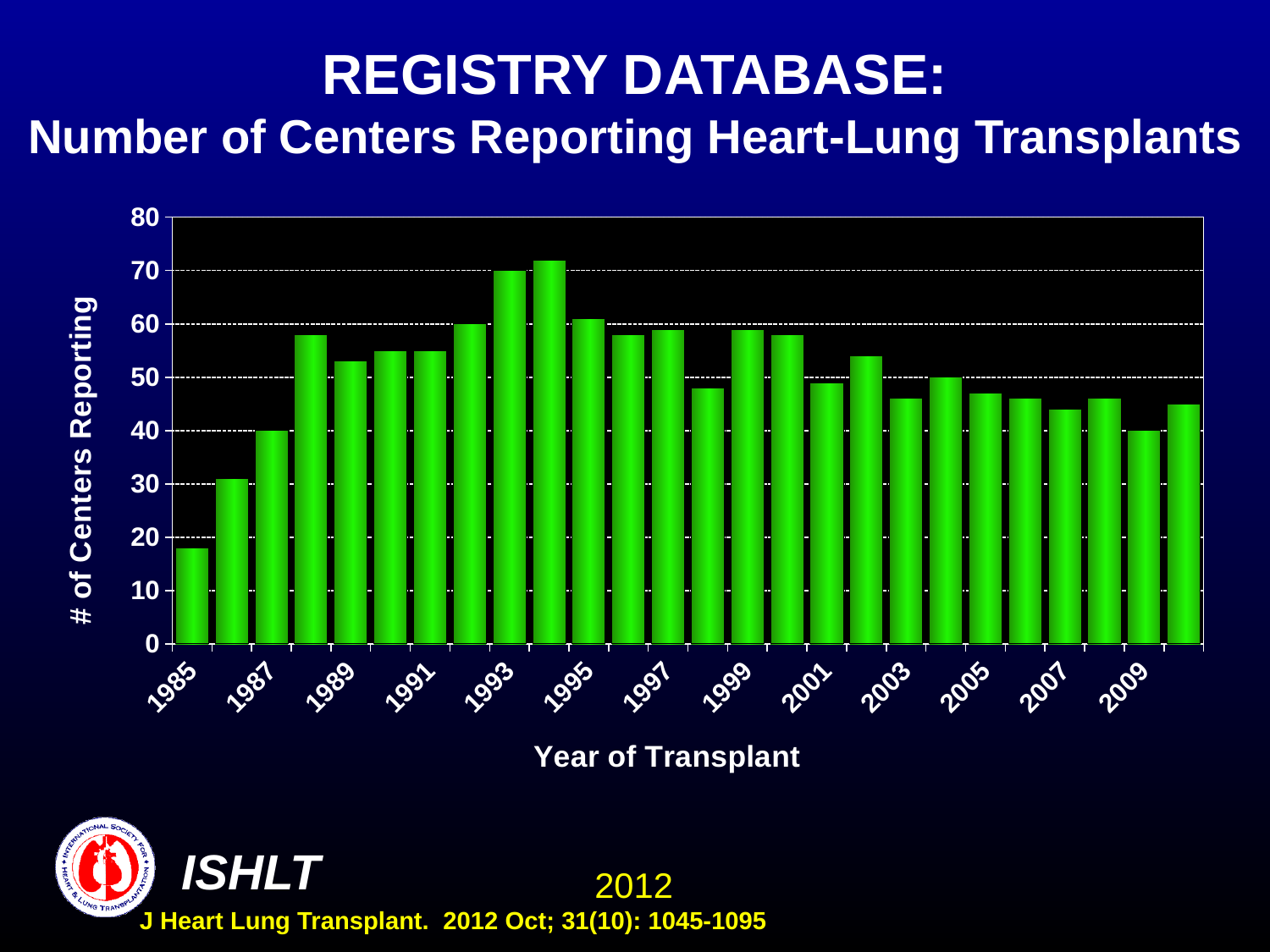
Which year has the highest number of centers reporting? 1994 Which year has more centers reporting, 1998 or 1999? 1999 Is the value for 1993 greater or less than 60? greater Which year has more centers reporting, 1993 or 2003? 1993 Is the value for 2007 greater or less than 50? less What kind of chart is shown on the slide? bar chart Is the value for 1985 greater or less than 20? less Do the values rise or fall from 1985 to 1988? rise How many bars (years) are plotted in the chart? 26 Which year has the lowest number of centers reporting? 1985 What is the title of the x axis? Year of Transplant